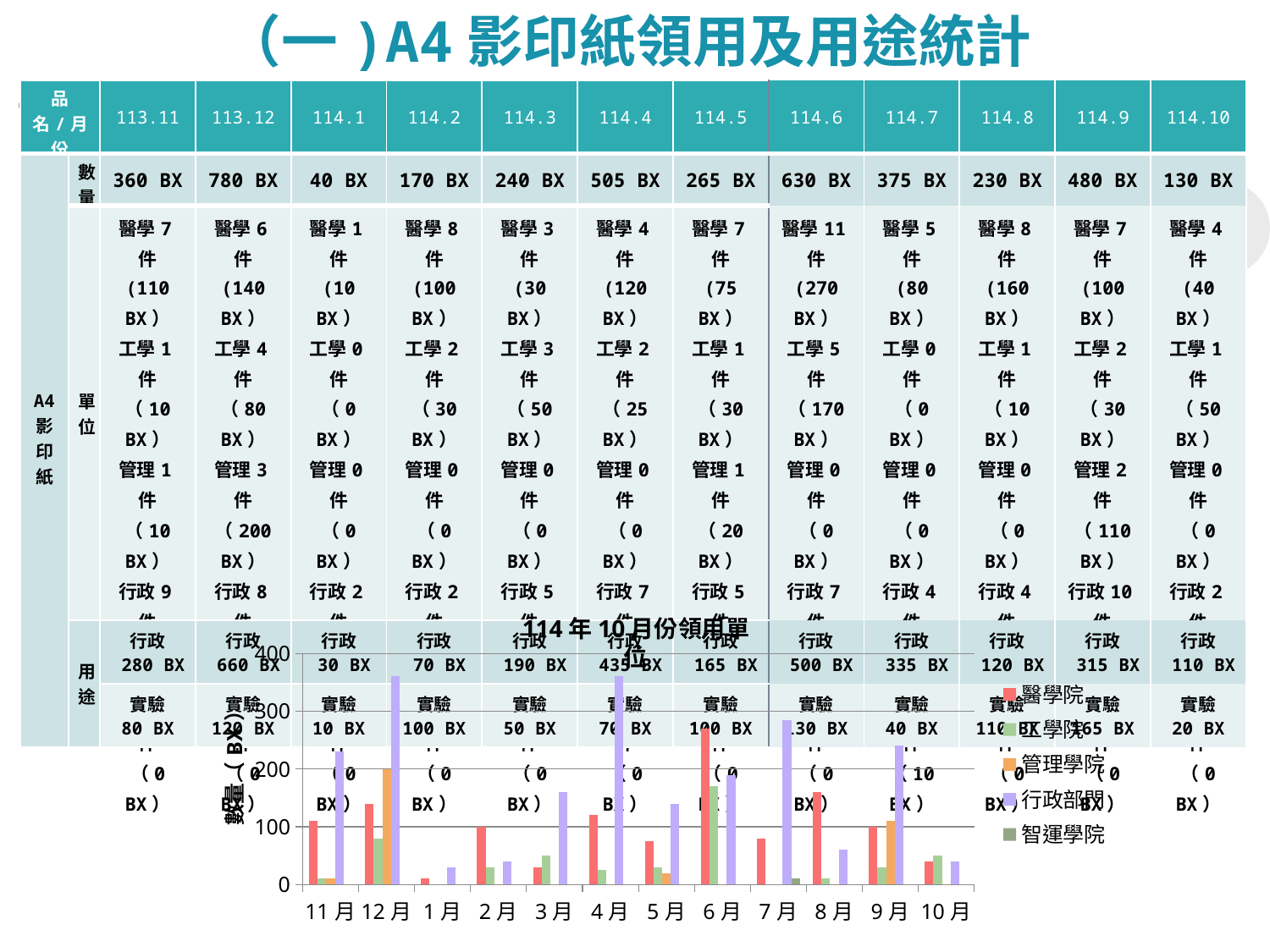
Is the value for 醫學院 in 1月 greater or less than 100? less What kind of chart is shown at the bottom of the slide? bar chart Is the value for 醫學院 in 6月 greater or less than 200? greater In which month is the 醫學院 bar the highest? 6月 In 6月, which is larger: the bar for 醫學院 or the bar for 工學院? 醫學院 How many series does the chart's legend list? 5 Is the value for 行政部門 in 11月 greater or less than 100? greater In 12月, which is larger: the bar for 行政部門 or the bar for 醫學院? 行政部門 What is the label on the chart's vertical axis? 數量（BX） How many months are shown along the x axis of the chart? 12